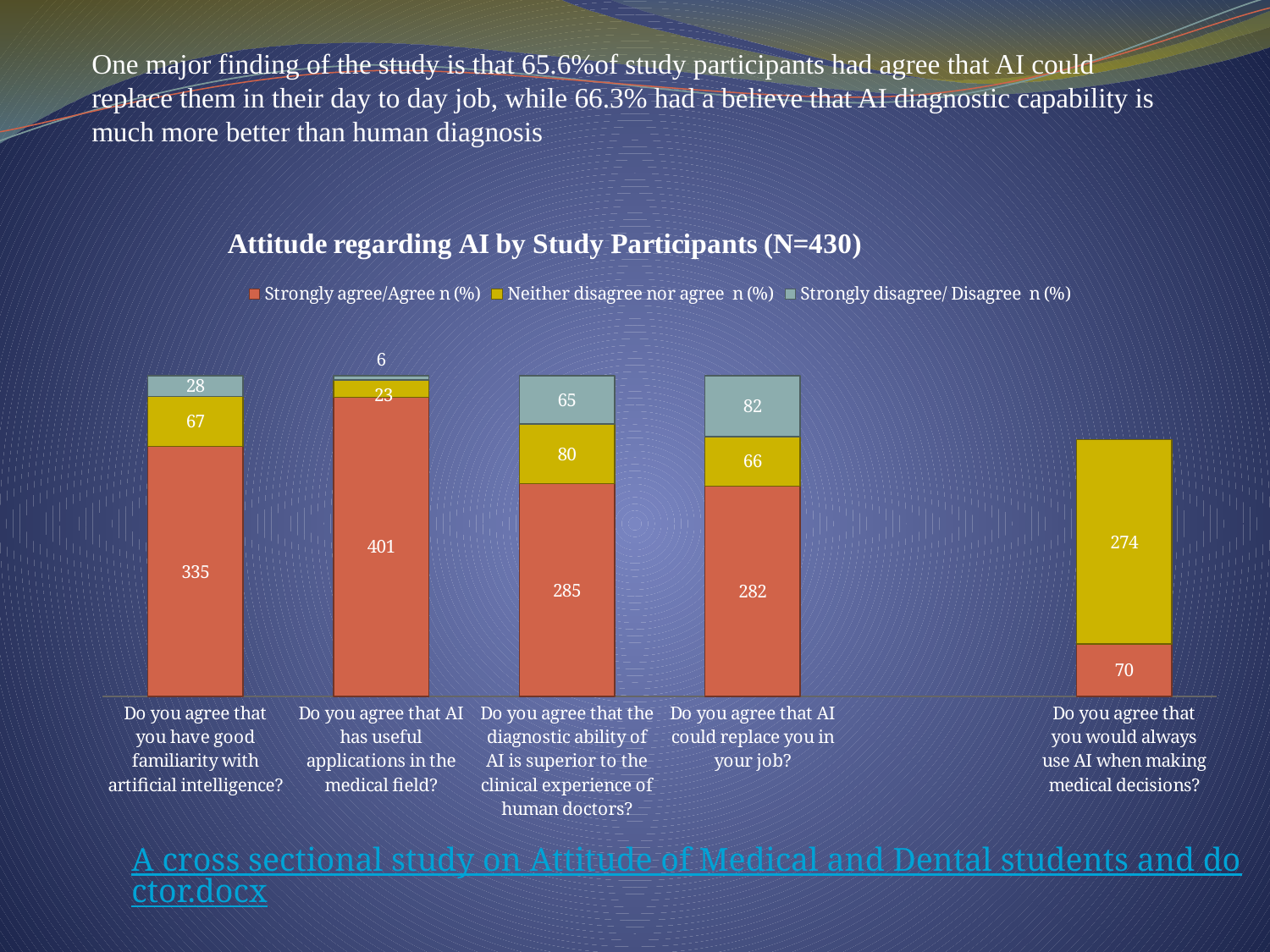
What is the Neither disagree nor agree value for "Do you agree that you would always use AI when making medical decisions?"? 274 What is the title of the chart? Attitude regarding AI by Study Participants (N=430) What is the total of the stacked bar for "Do you agree that you have good familiarity with artificial intelligence?"? 430 What is the difference between the Strongly agree/Agree values for the useful applications question (401) and the familiarity with AI question (335)? 66 What is the total of the stacked bar for the question about AI's diagnostic ability being superior to human doctors? 430 Which has the larger Strongly disagree/Disagree value: the diagnostic ability question or the replace you in your job question? Do you agree that AI could replace you in your job? Which question has the lowest Strongly agree/Agree value? Do you agree that you would always use AI when making medical decisions? What is the Neither disagree nor agree value for the question about AI's diagnostic ability being superior to the clinical experience of human doctors? 80 How many series does the legend list? 3 Which question has the highest Strongly agree/Agree value? Do you agree that AI has useful applications in the medical field? What is the Strongly agree/Agree value for "Do you agree that AI has useful applications in the medical field?"? 401 What is the Strongly disagree/Disagree value for "Do you agree that AI could replace you in your job?"? 82